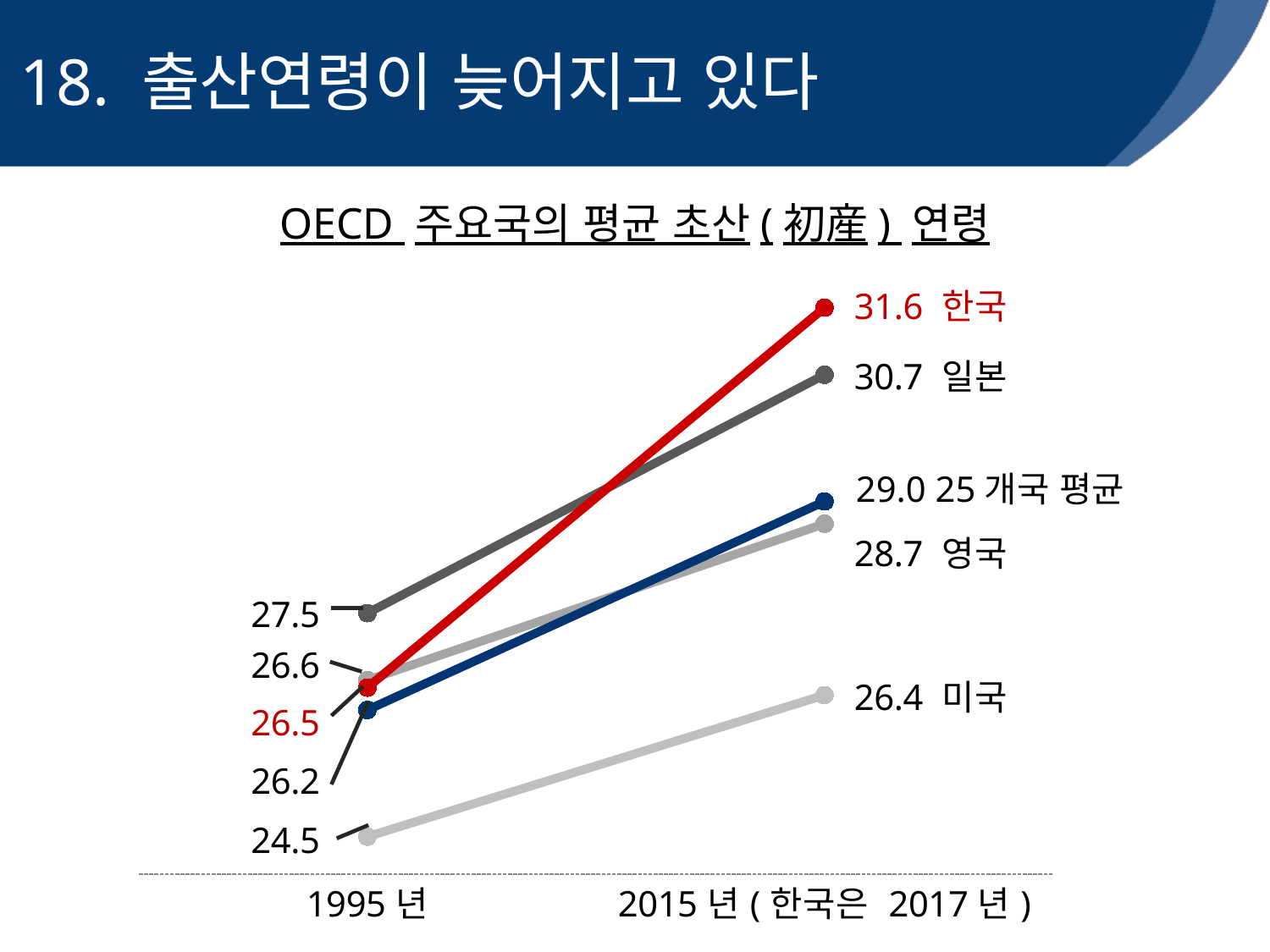
What was the average age at first birth for 일본 in 1995년? 27.5 Which country or group has the lowest value in 1995년? 미국 What is the difference between the 2015년 values for 한국 and 일본? 0.9 What kind of chart is shown on the slide? Line chart What is the average age at first birth for 한국 at the 2015년 (한국은 2017년) point? 31.6 At the 2015년 point, which is larger: 25개국 평균 or 영국? 25개국 평균 Do the values rise or fall from 1995년 to 2015년 for all lines? Rise What was the value for 25개국 평균 in 1995년? 26.2 How many countries or groups are plotted on the chart? 5 By how much did the value for 한국 increase from 1995년 to the 2017년 point? 5.1 Which country or group has the highest value at the 2015년 point? 한국 What is the value for 미국 at the 2015년 point? 26.4